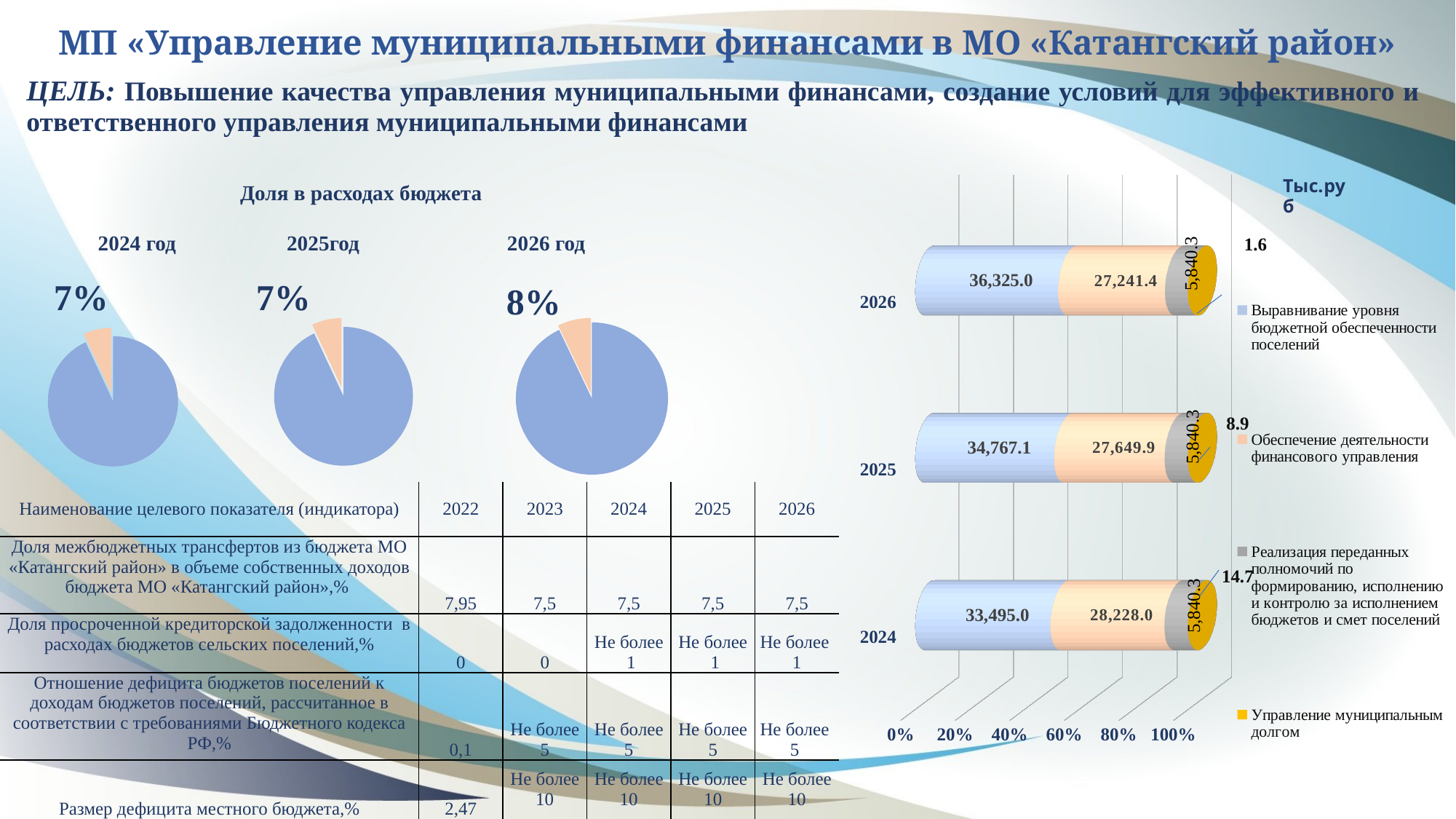
In the stacked bar chart on the right, what is the value for «Выравнивание уровня бюджетной обеспеченности поселений» in 2026? 36,325.0 In the stacked bar chart on the right, what is the difference between the «Выравнивание уровня бюджетной обеспеченности поселений» values for 2026 and 2025? 1,557.9 How many years (bars) are shown in the stacked bar chart on the right? 3 In the pie chart for 2026 год under «Доля в расходах бюджета», what share is shown? 8% In the stacked bar chart on the right, what is the value for «Обеспечение деятельности финансового управления» in 2024? 28,228.0 In the stacked bar chart on the right, what is the total of all segments for the 2026 bar? 69,408.3 In the stacked bar chart on the right, what is the value for «Управление муниципальным долгом» in 2024? 14.7 How many series does the legend of the stacked bar chart on the right list? 4 In the stacked bar chart on the right, which year has the highest value for «Выравнивание уровня бюджетной обеспеченности поселений»? 2026 In the pie chart for 2024 год under «Доля в расходах бюджета», what share is shown? 7% In the stacked bar chart on the right, what is the value for «Реализация переданных полномочий» in 2025? 5,840.3 What kind of chart is the chart on the right side of the slide? Stacked bar chart